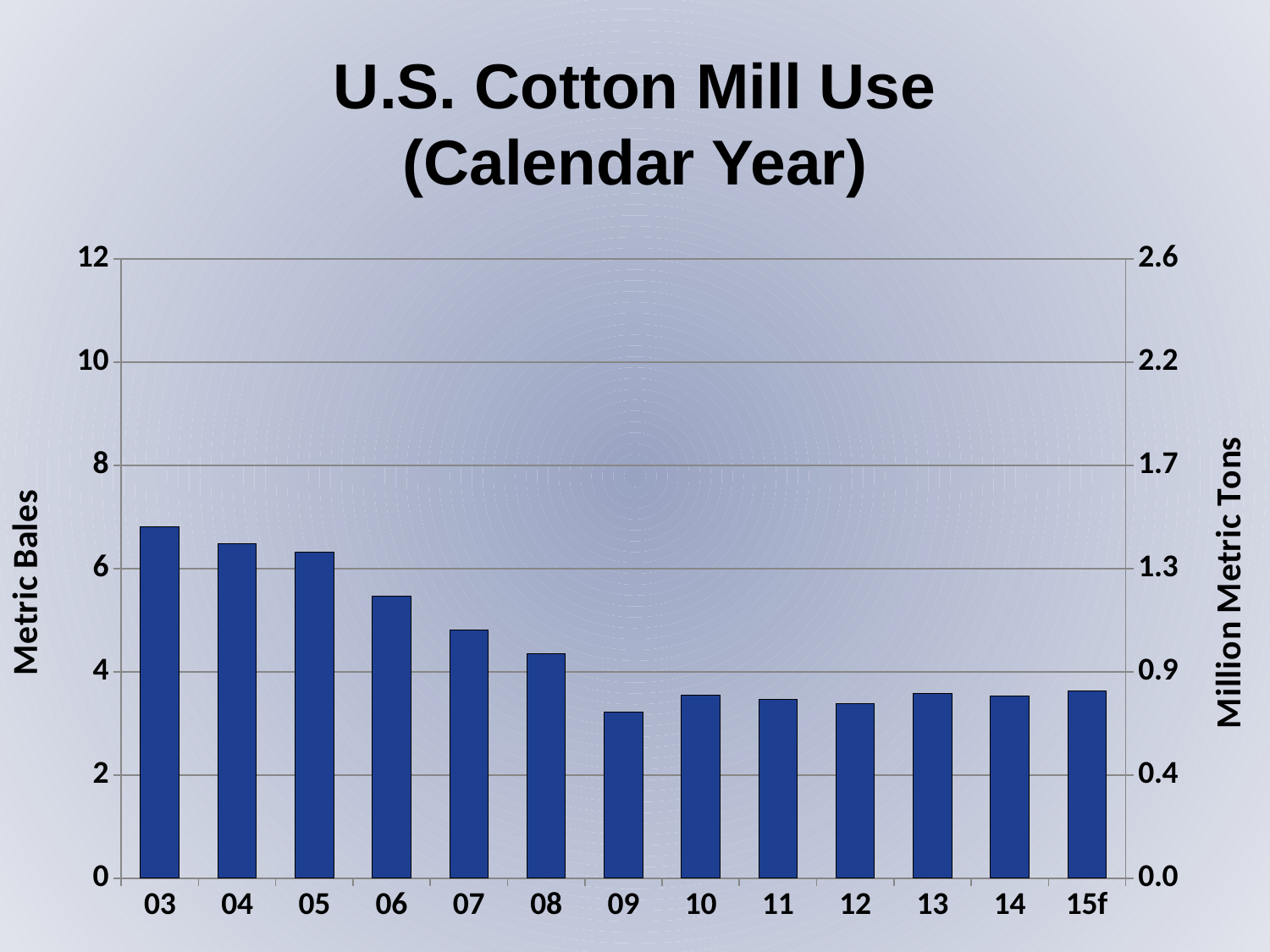
Which is larger, the value for 05 or the value for 07? 05 What is the label on the right vertical axis? Million Metric Tons Is the value for 08 greater or less than 4 metric bales? greater Is the value for 09 greater or less than 4 metric bales? less Which year has the highest U.S. cotton mill use? 03 What is the label on the left vertical axis? Metric Bales Is the value for 03 greater or less than 6 metric bales? greater What kind of chart is shown on the slide? bar chart How many years (categories) are plotted on the x axis? 13 Do the values generally rise or fall from 03 to 09? fall